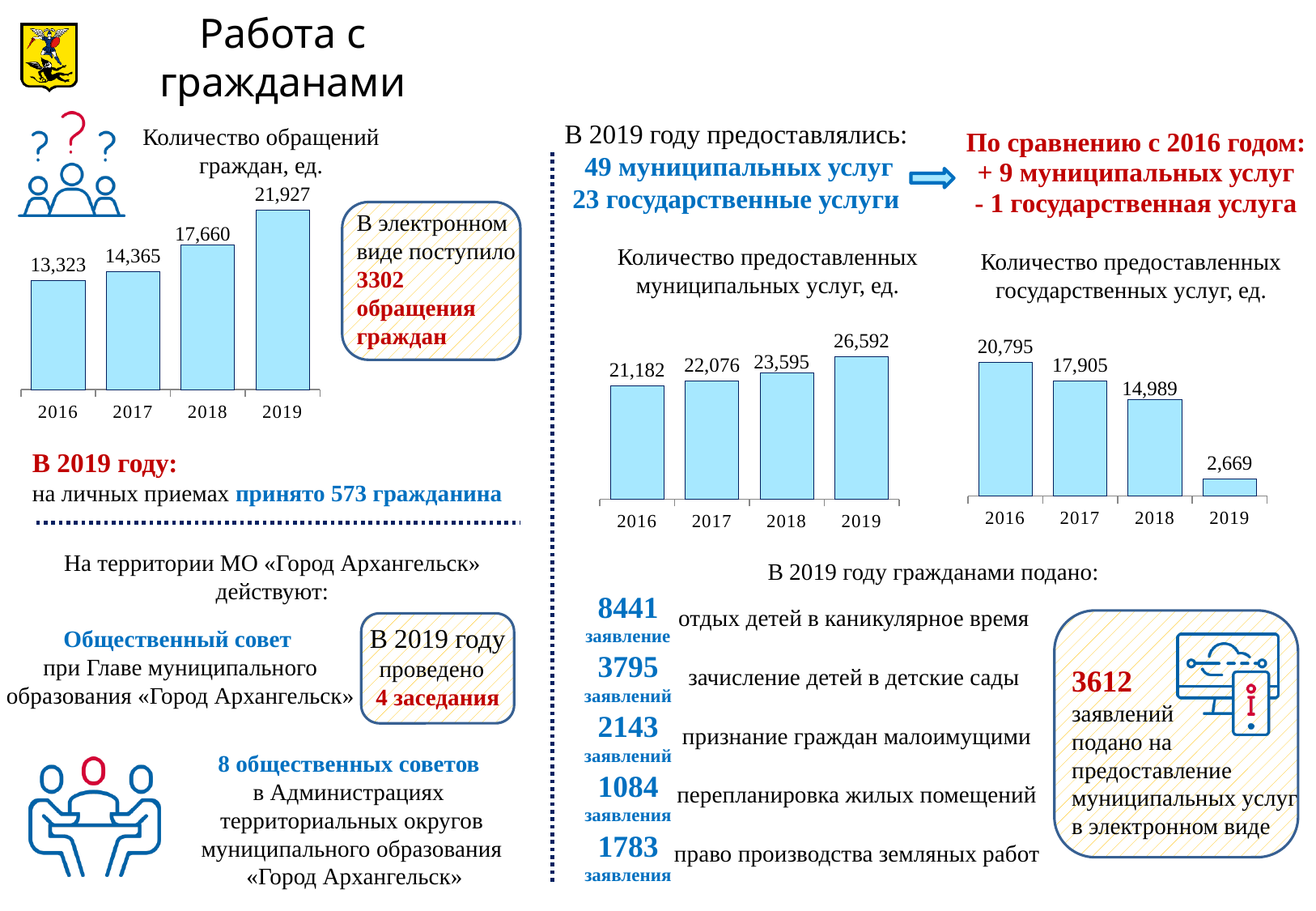
In the chart "Количество предоставленных муниципальных услуг, ед.", how many years are shown? 4 In the chart "Количество предоставленных государственных услуг, ед.", what is the difference between the 2016 and 2018 values? 5,806 In the chart "Количество обращений граждан, ед.", what is the value for 2019? 21,927 In the chart "Количество предоставленных государственных услуг, ед.", what is the value for 2019? 2,669 In the chart "Количество обращений граждан, ед.", what is the difference between the 2019 and 2016 values? 8,604 In the chart "Количество предоставленных государственных услуг, ед.", which year has the highest value? 2016 In the chart "Количество предоставленных муниципальных услуг, ед.", which year has the highest value? 2019 In the chart "Количество предоставленных муниципальных услуг, ед.", what is the value for 2017? 22,076 In the chart "Количество обращений граждан, ед.", do the values rise or fall from 2016 to 2019? rise In the chart "Количество предоставленных государственных услуг, ед.", do the values rise or fall from 2016 to 2019? fall In the chart "Количество обращений граждан, ед.", which year has the lowest value? 2016 What type of chart is "Количество обращений граждан, ед."? bar chart